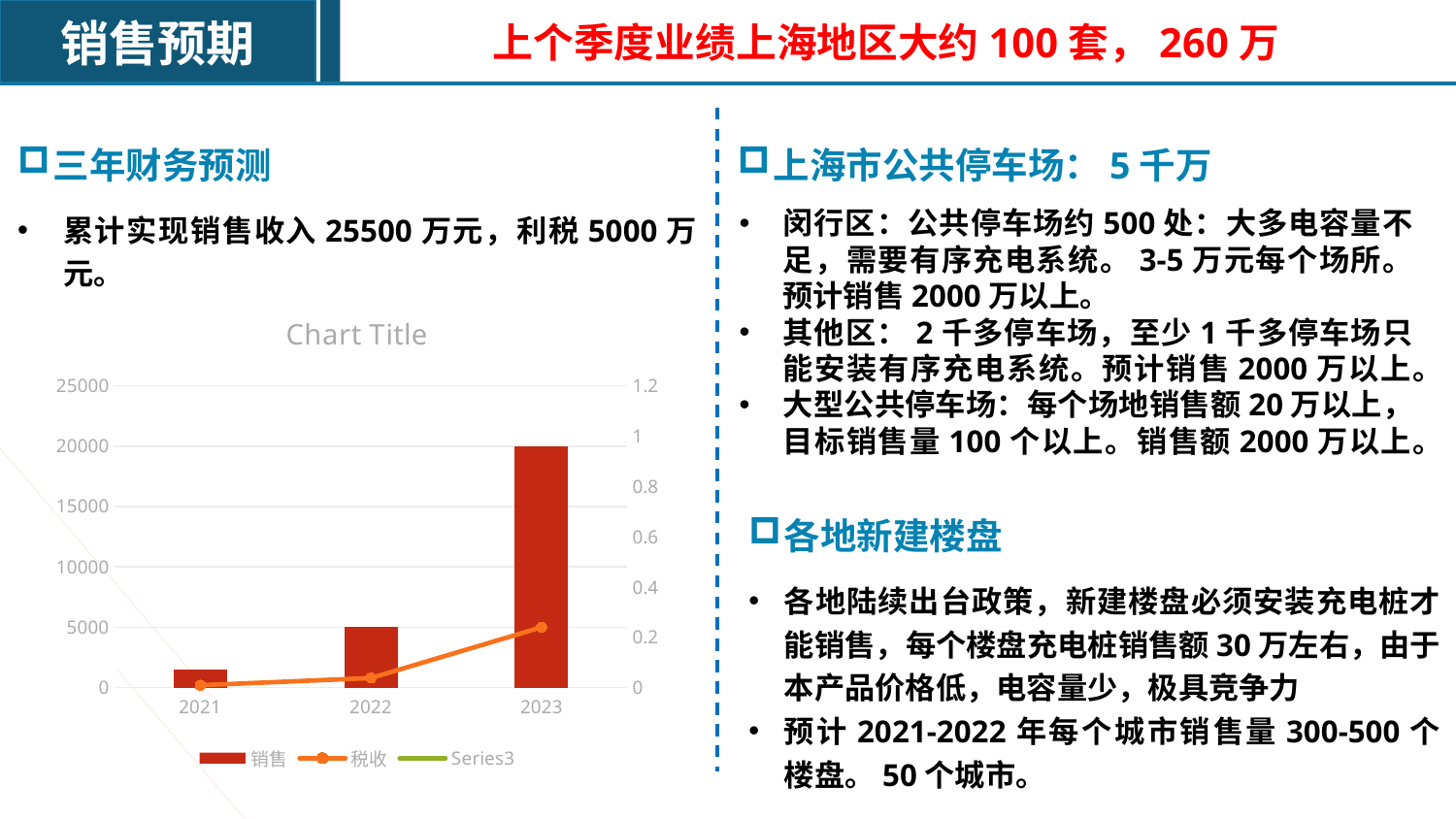
Is the 销售 value for 2023 greater or less than 15000? greater Which year has the larger 销售 bar, 2021 or 2022? 2022 Is the 销售 value for 2021 greater or less than 5000? less What is the title shown above the chart? Chart Title Do the 销售 bars rise or fall from 2021 to 2023? rise How many series does the chart legend list? 3 What kind of chart is shown on the slide? bar chart with a line Which year has the lowest 销售 bar? 2021 Which year has the highest 销售 bar? 2023 How many years are shown on the x axis of the chart? 3 Is the 销售 value for 2022 greater or less than 10000? less